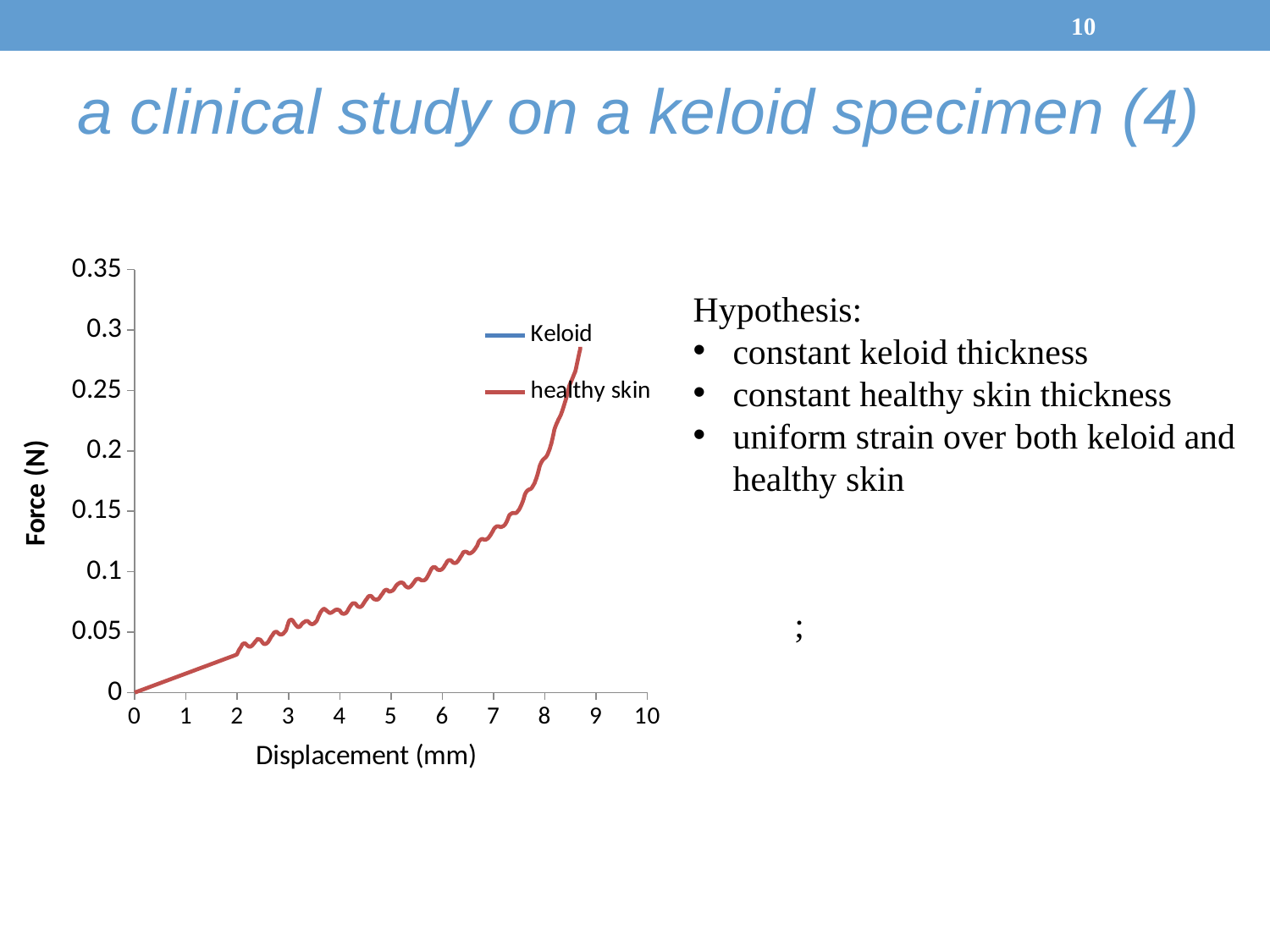
Is the force value at a displacement of 2 mm greater or less than 0.05 N? less How many tick labels are shown on the x axis? 11 What are the two series named in the chart's legend? Keloid and healthy skin Is the highest force value reached by the healthy skin curve greater or less than 0.25 N? greater What kind of chart is shown on the slide? line chart Is the force value at a displacement of 4 mm greater or less than 0.1 N? less What is the label of the chart's x axis? Displacement (mm) What is the highest tick value shown on the y axis (Force)? 0.35 Does the force value rise or fall as displacement increases along the x axis? rise Is the force at a displacement of 6 mm greater or less than the force at a displacement of 8 mm? less How many series does the chart's legend list? 2